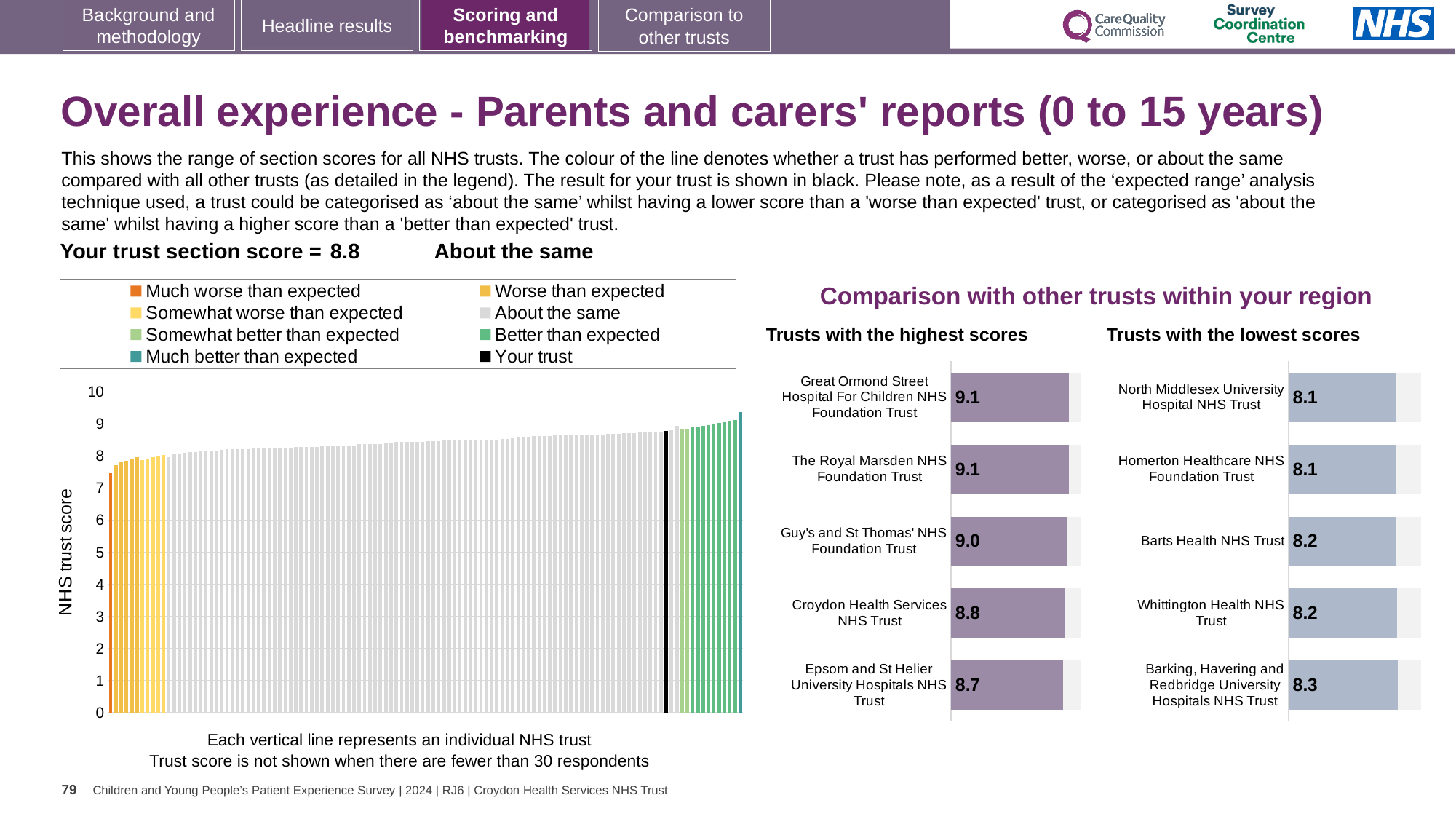
In the 'Trusts with the lowest scores' chart, which trust has the highest score? Barking, Havering and Redbridge University Hospitals NHS Trust What kind of chart is the main chart on the left showing all NHS trusts? bar chart In the main chart on the left, is the value for the black 'Your trust' bar greater or less than 8? greater In the 'Trusts with the lowest scores' chart, what is the score for Barts Health NHS Trust? 8.2 In the main chart on the left, do the trust scores rise or fall from left to right? rise In the 'Trusts with the highest scores' chart, what is the difference between the scores of Great Ormond Street Hospital For Children NHS Foundation Trust and Epsom and St Helier University Hospitals NHS Trust? 0.4 In the 'Trusts with the highest scores' chart, what is the score for Epsom and St Helier University Hospitals NHS Trust? 8.7 How many entries does the legend of the main chart on the left list? 8 In the 'Trusts with the highest scores' chart, what is the score for Guy's and St Thomas' NHS Foundation Trust? 9.0 In the 'Trusts with the highest scores' chart, which trust has the lowest score? Epsom and St Helier University Hospitals NHS Trust In the 'Trusts with the lowest scores' chart, how many trusts are listed? 5 In the 'Trusts with the lowest scores' chart, which has the larger score: Homerton Healthcare NHS Foundation Trust or Whittington Health NHS Trust? Whittington Health NHS Trust